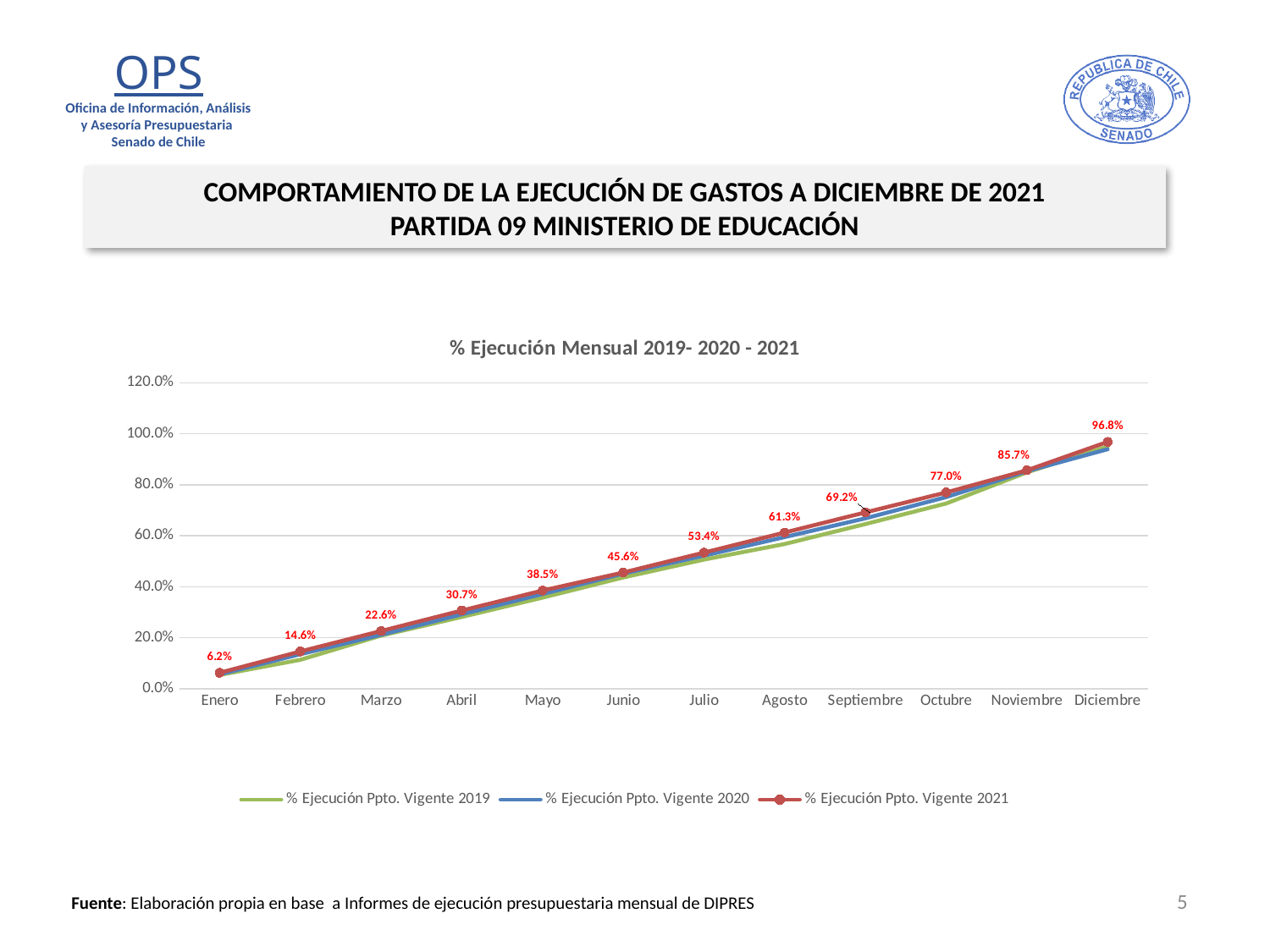
In which month is the % Ejecución Ppto. Vigente 2021 series lowest? Enero In which month does the % Ejecución Ppto. Vigente 2021 series reach its highest value? Diciembre What is the difference between the 2021 values for Diciembre and Noviembre? 11.1% How many series does the legend list? 3 What kind of chart is shown on the slide? line chart What is the value for % Ejecución Ppto. Vigente 2021 in Octubre? 77.0% What is the difference between the 2021 values for Agosto and Julio? 7.9% How many months are shown on the x axis? 12 What is the value for % Ejecución Ppto. Vigente 2021 in Enero? 6.2% Which is larger for the 2021 series: the value in Marzo or the value in Abril? Abril What is the value for % Ejecución Ppto. Vigente 2021 in Junio? 45.6% Is the value for % Ejecución Ppto. Vigente 2019 in Octubre greater or less than 80.0%? less